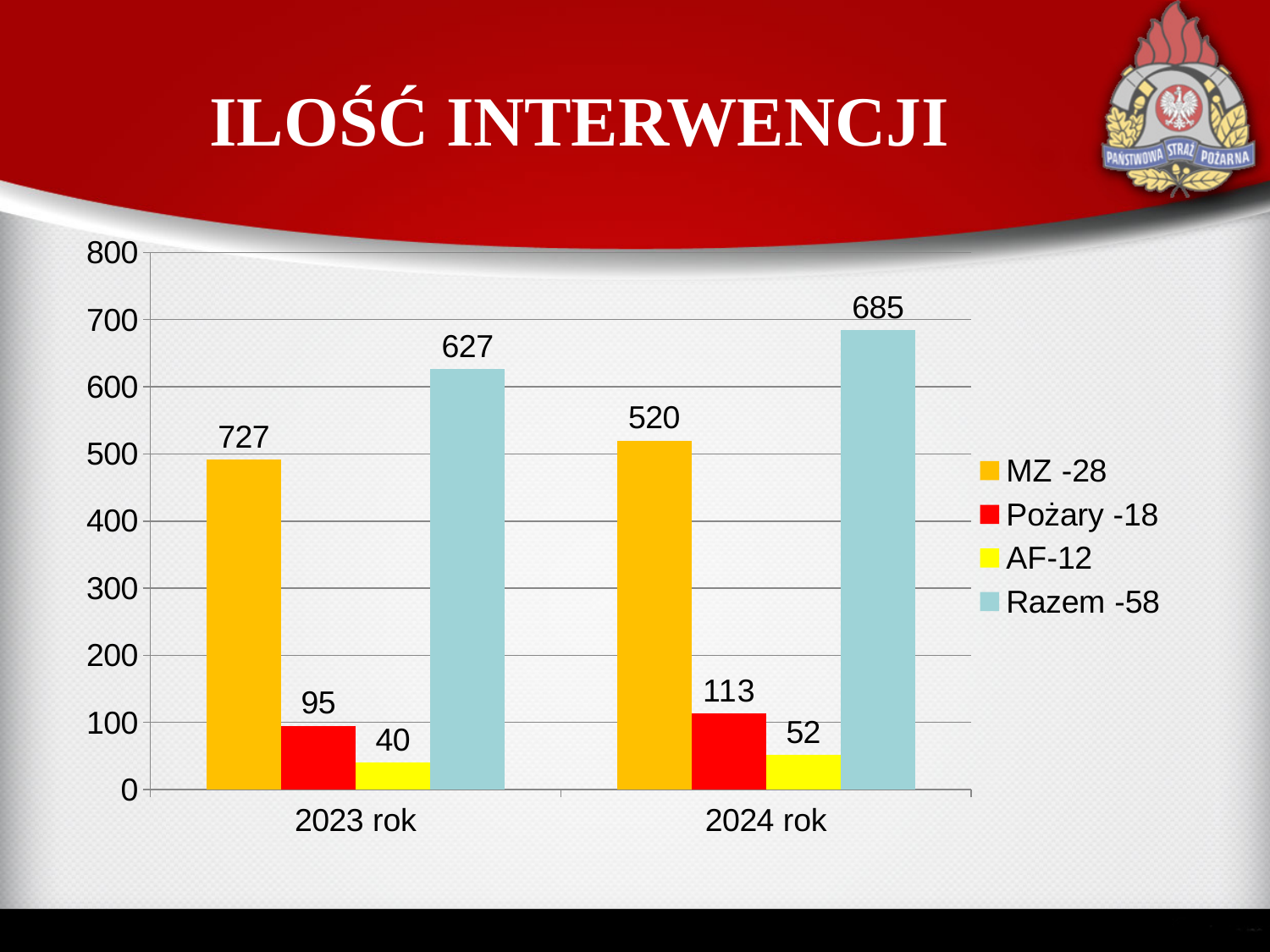
By how much did the Razem -58 value increase from 2023 rok to 2024 rok? 58 How many series does the legend list? 4 What is the value of MZ -28 for 2024 rok? 520 What is the title of the slide? ILOŚĆ INTERWENCJI What is the value of AF-12 for 2023 rok? 40 What is the value of Razem -58 for 2023 rok? 627 Which series has the lowest value for 2024 rok? AF-12 Which year has the larger AF-12 value, 2023 rok or 2024 rok? 2024 rok What is the difference between the Pożary -18 values for 2024 rok and 2023 rok? 18 What kind of chart is shown on the slide? bar chart What is the value of Razem -58 for 2024 rok? 685 What is the value of Pożary -18 for 2024 rok? 113